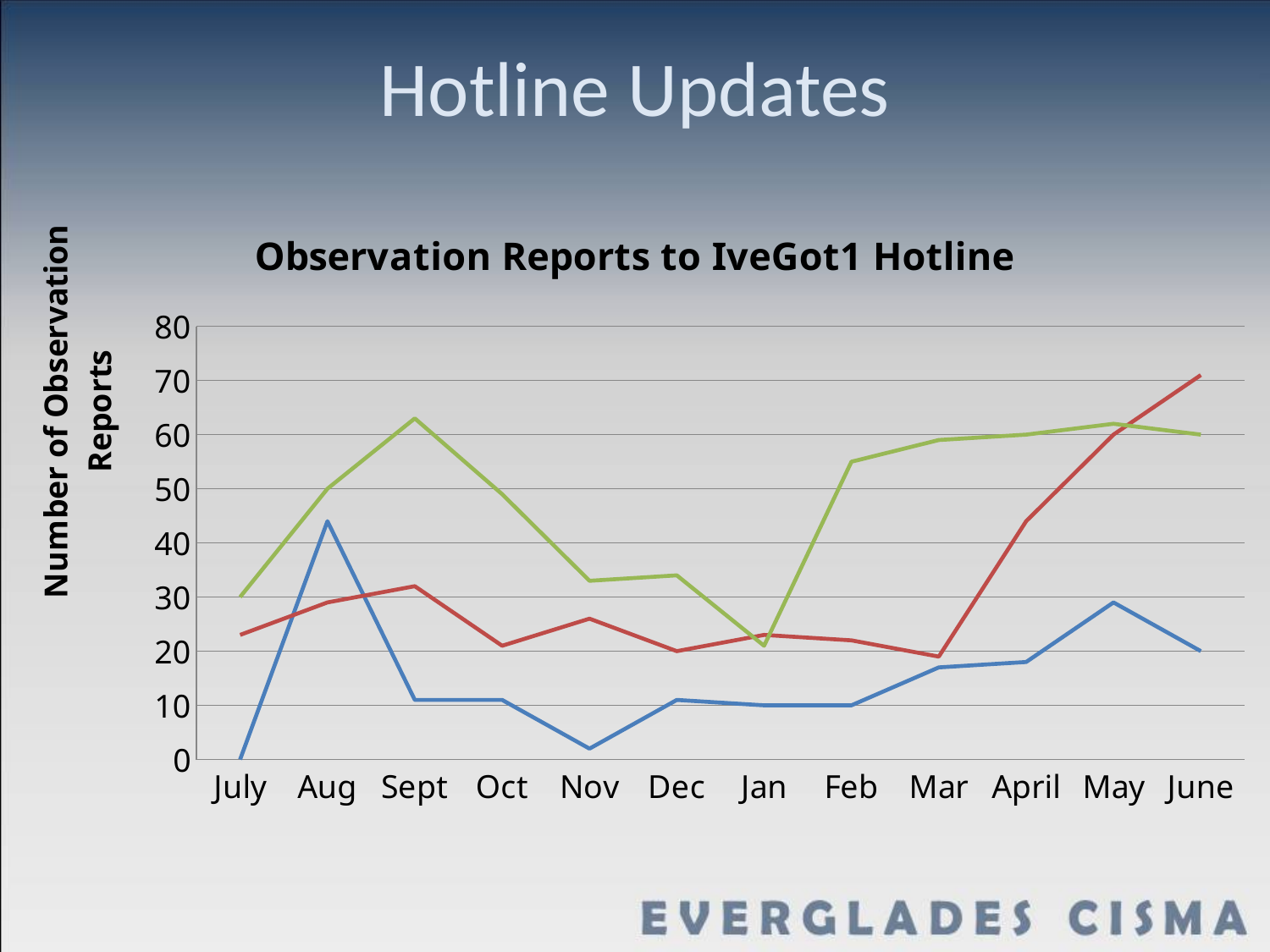
In which month does the red line reach its highest value? June What kind of chart is shown on the slide? line chart What is the label on the vertical axis of the chart? Number of Observation Reports What is the title of the chart? Observation Reports to IveGot1 Hotline Is the value of the blue line in Nov greater or less than 10? less Is the value of the red line in June greater or less than 60? greater Is the value of the green line in Sept greater or less than 50? greater In which month does the blue line reach its highest value? Aug How many lines are plotted on the chart? 3 In which month does the green line reach its lowest value? Jan How many months are shown along the x axis of the chart? 12